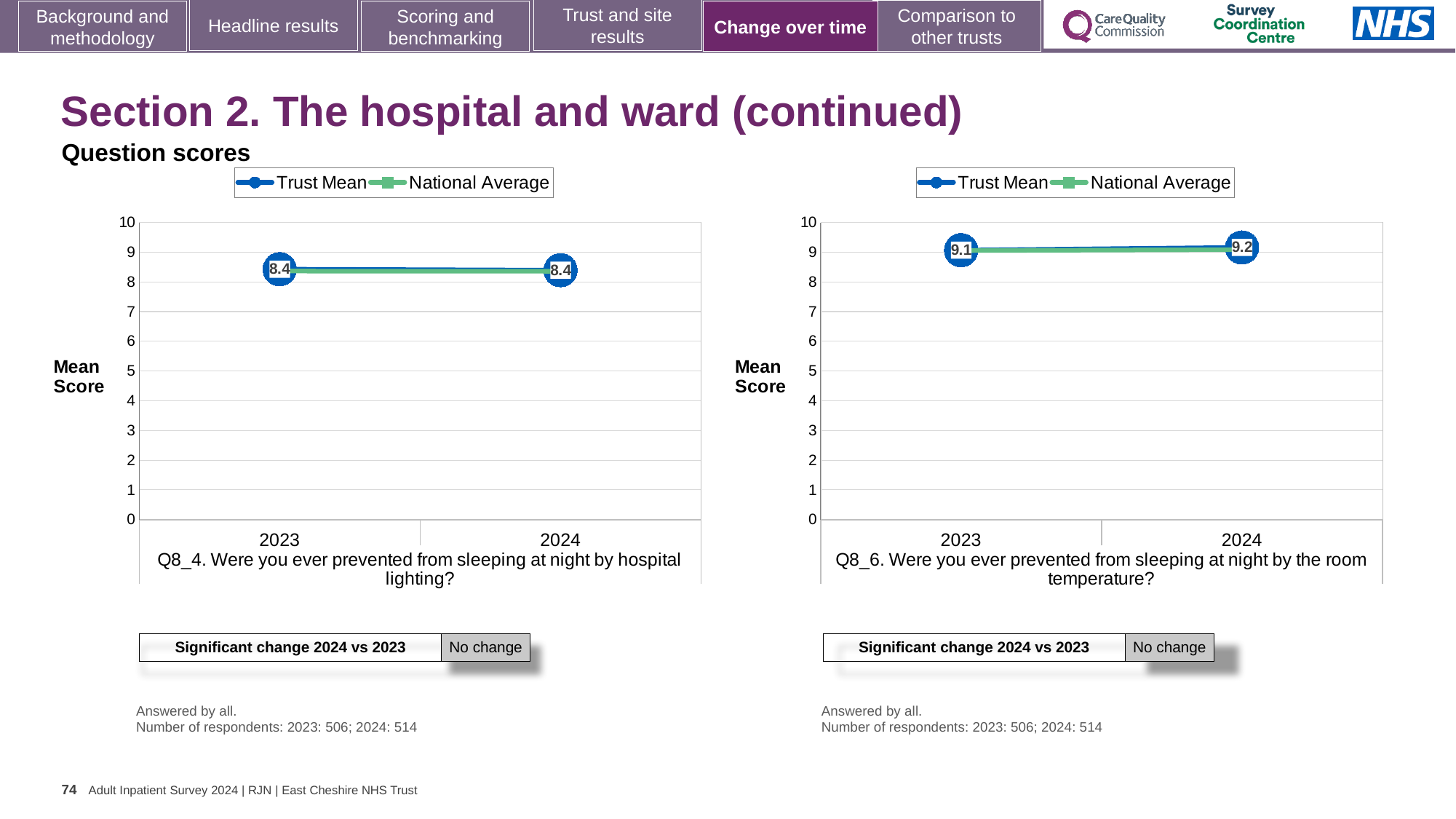
In the right chart (Q8_6, room temperature), what is the difference between the Trust Mean scores for 2024 and 2023? 0.1 How many series does the legend of the left chart (Q8_4) list? 2 In the right chart (Q8_6, room temperature), what is the Trust Mean score for 2024? 9.2 In the left chart (Q8_4, hospital lighting), is the Trust Mean for 2023 greater or less than 5? greater In the left chart (Q8_4, hospital lighting), does the Trust Mean rise, fall or stay the same from 2023 to 2024? stay the same What kind of chart is the left chart (Q8_4, hospital lighting)? line chart In the left chart (Q8_4, hospital lighting), what is the Trust Mean score for 2023? 8.4 How many years are plotted on the x axis of the right chart (Q8_6)? 2 In the right chart (Q8_6, room temperature), does the Trust Mean rise, fall or stay the same from 2023 to 2024? rise In the right chart (Q8_6, room temperature), what is the Trust Mean score for 2023? 9.1 What are the two series named in the legend of the right chart (Q8_6)? Trust Mean and National Average In the left chart (Q8_4, hospital lighting), what is the Trust Mean score for 2024? 8.4